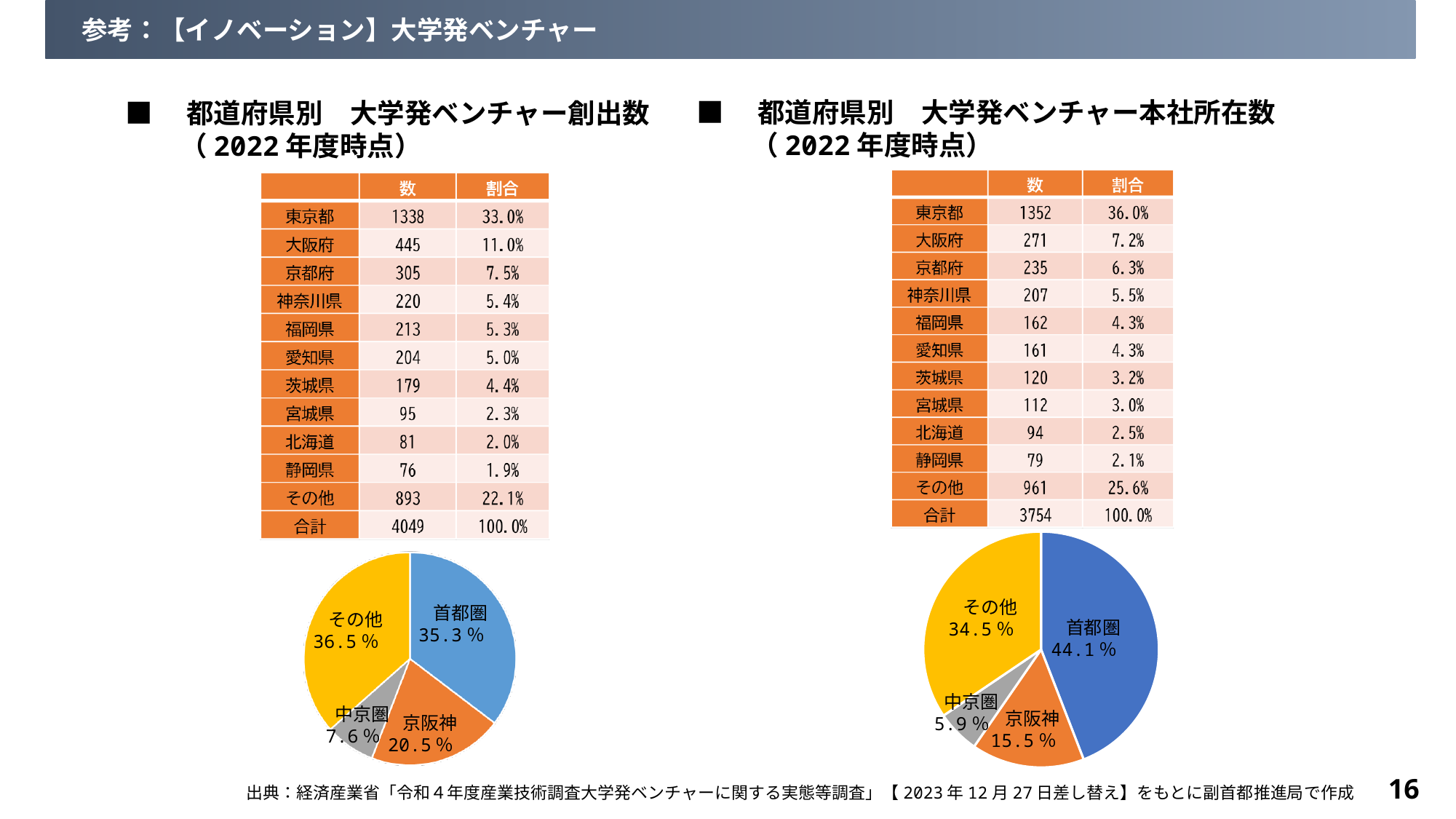
In the left pie chart (大学発ベンチャー創出数), what share is labelled for 首都圏? 35.3% Which is larger: the 京阪神 share in the left pie chart (創出数) or the 京阪神 share in the right pie chart (本社所在数)? Left pie chart (創出数), 20.5% In the left pie chart (大学発ベンチャー創出数), what share is labelled for 京阪神? 20.5% In the right pie chart (大学発ベンチャー本社所在数), what share is labelled for 首都圏? 44.1% In the right pie chart (大学発ベンチャー本社所在数), which slice is the largest? 首都圏 What type of chart is used below each table on the slide? Pie chart How many slices does the left pie chart (大学発ベンチャー創出数) have? 4 In the right pie chart (大学発ベンチャー本社所在数), what share is labelled for 中京圏? 5.9% In the left pie chart (大学発ベンチャー創出数), which slice is the largest? その他 In the right pie chart (大学発ベンチャー本社所在数), what is the difference between the 首都圏 share and the 京阪神 share? 28.6% In the left pie chart (大学発ベンチャー創出数), what is the difference between the その他 share and the 首都圏 share? 1.2% In the right pie chart (大学発ベンチャー本社所在数), which slice is the smallest? 中京圏